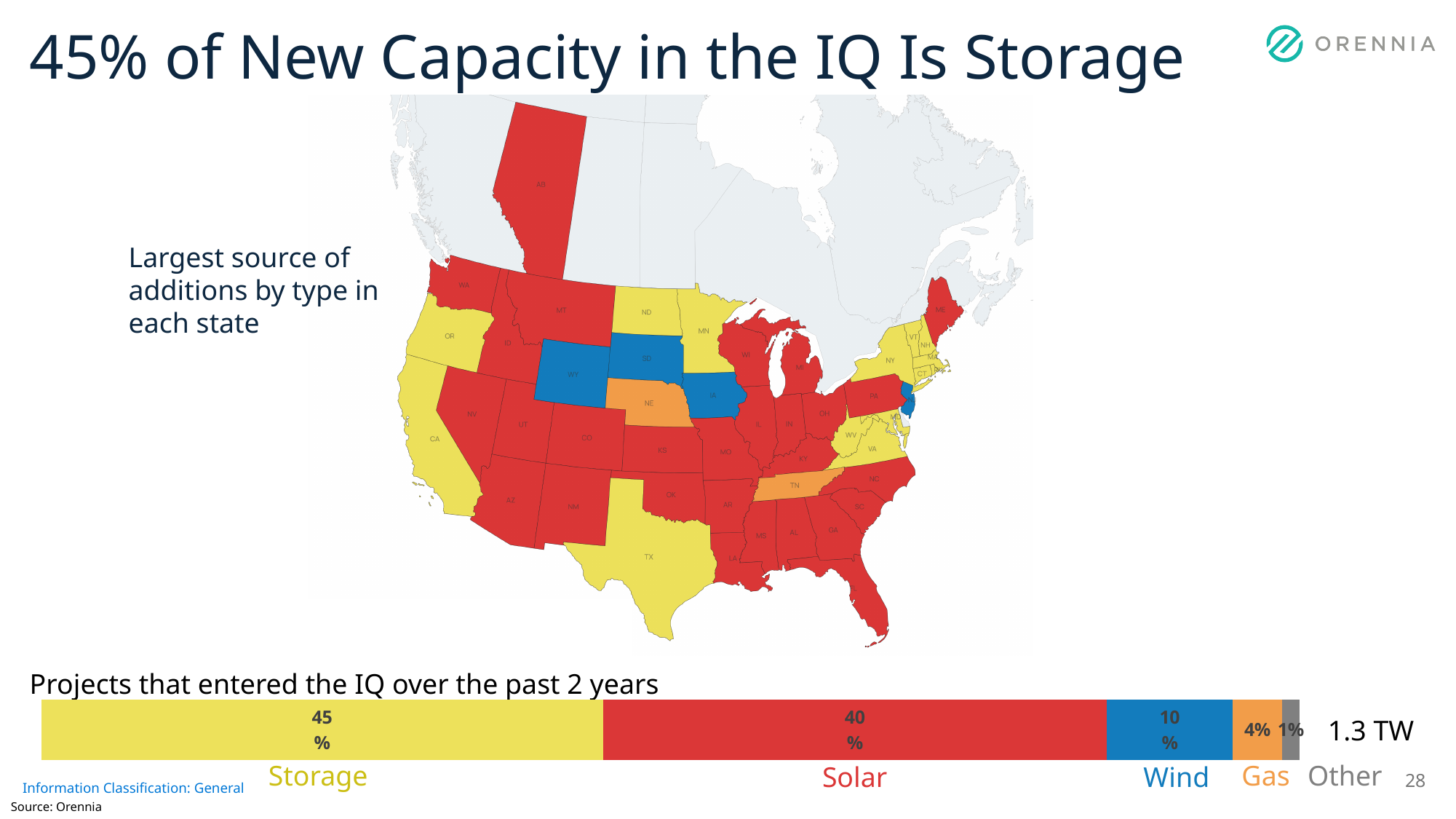
How many categories are shown in the bar chart 'Projects that entered the IQ over the past 2 years'? 5 In the bar chart 'Projects that entered the IQ over the past 2 years', which category has the largest share? Storage In the bar chart 'Projects that entered the IQ over the past 2 years', what is the difference in percentage points between Storage and Solar? 5 percentage points In the bar chart 'Projects that entered the IQ over the past 2 years', what share is Wind? 10% In the bar chart 'Projects that entered the IQ over the past 2 years', which is larger, Wind or Gas? Wind In the bar chart 'Projects that entered the IQ over the past 2 years', what share is Gas? 4% What total capacity is labelled at the end of the bar chart 'Projects that entered the IQ over the past 2 years'? 1.3 TW What kind of chart is 'Projects that entered the IQ over the past 2 years'? Stacked bar chart On the map, which colour is used for states where Solar is the largest source of additions? Red In the bar chart 'Projects that entered the IQ over the past 2 years', what share is Storage? 45% In the bar chart 'Projects that entered the IQ over the past 2 years', which category has the smallest share? Other In the bar chart 'Projects that entered the IQ over the past 2 years', what share is Solar? 40%